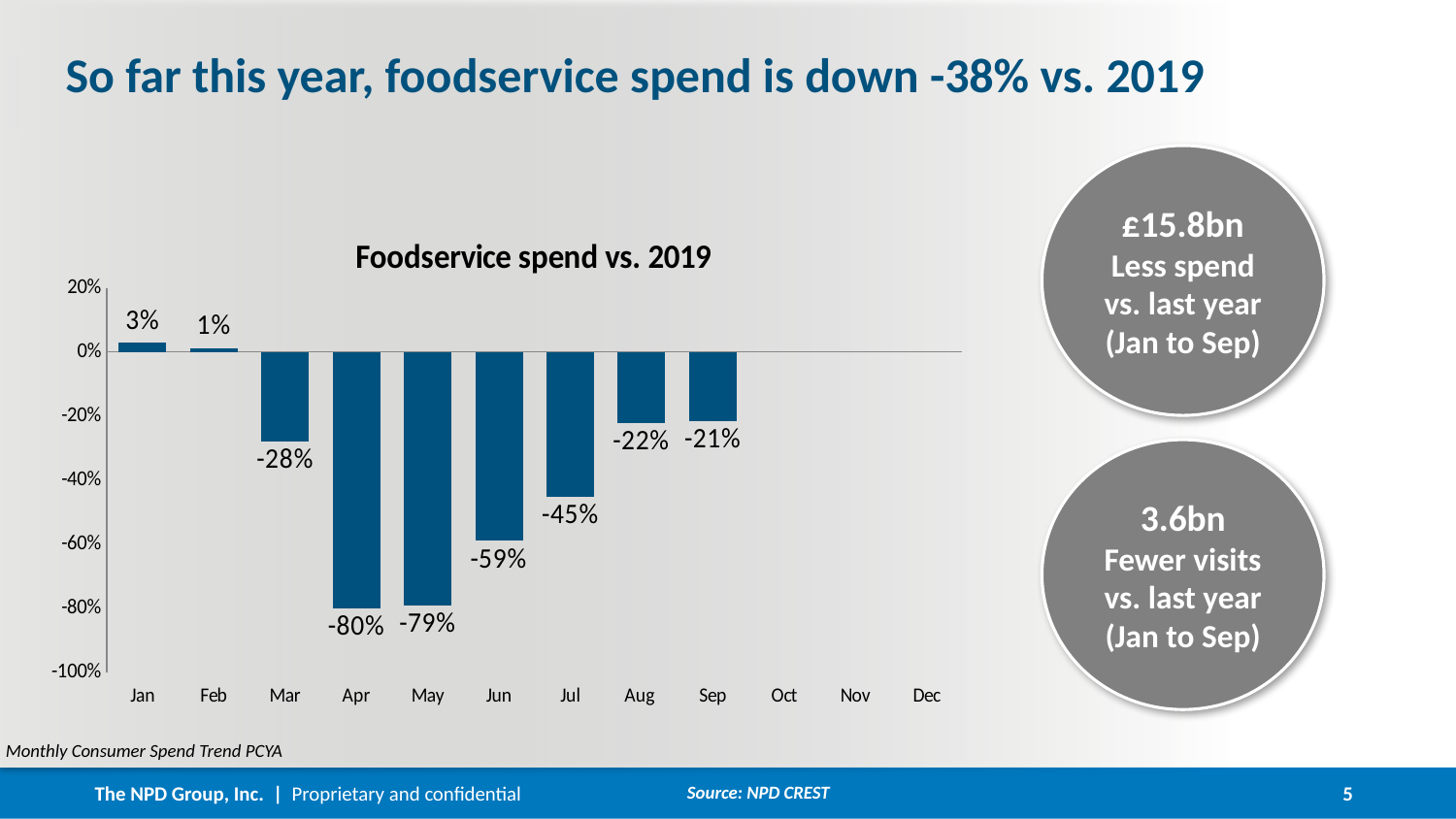
What is the value for Apr in the Foodservice spend vs. 2019 chart? -80% Which month has the lowest value in the chart? Apr What is the value for Sep in the Foodservice spend vs. 2019 chart? -21% Which month has the larger value, Jun or Jul? Jul What is the title of the chart? Foodservice spend vs. 2019 Which month has the highest value in the chart? Jan What type of chart is shown on the slide? Bar chart What is the difference between the values for Jun and Jul? 14 percentage points Is the value for Mar greater or less than -20%? less What is the value for Jan in the Foodservice spend vs. 2019 chart? 3% How many months have bars plotted in the chart? 9 Do the values rise or fall from Apr to Sep? Rise